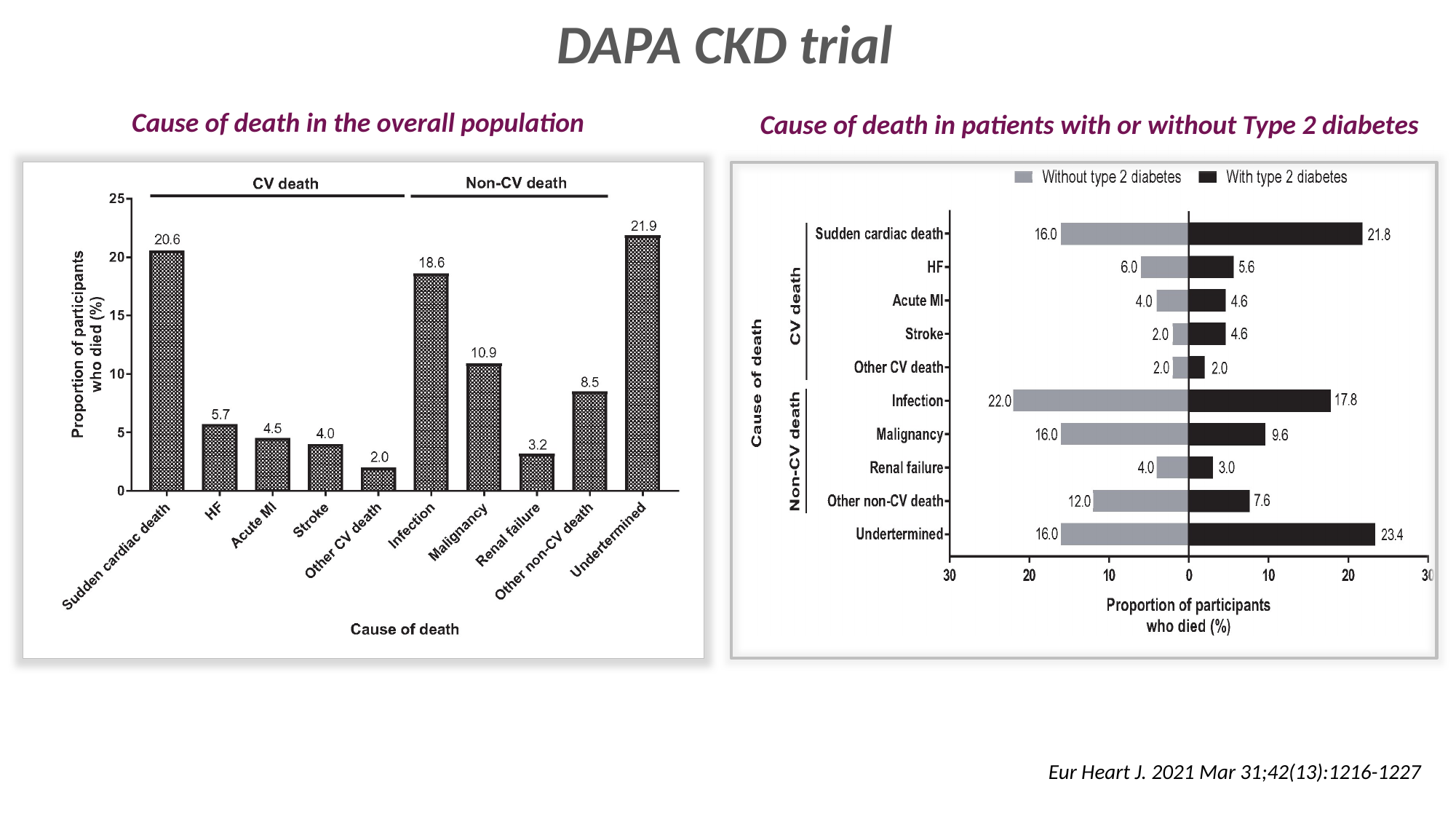
In the 'Cause of death in patients with or without Type 2 diabetes' chart, how many series does the legend list? 2 What kind of chart is the 'Cause of death in the overall population' chart? Bar chart In the 'Cause of death in the overall population' chart, which cause of death has the highest proportion? Undertermined In the 'Cause of death in patients with or without Type 2 diabetes' chart, which is larger for Malignancy: the value without type 2 diabetes or with type 2 diabetes? Without type 2 diabetes In the 'Cause of death in patients with or without Type 2 diabetes' chart, what is the value for Undertermined in patients with type 2 diabetes? 23.4 In the 'Cause of death in patients with or without Type 2 diabetes' chart, what is the value for Infection in patients without type 2 diabetes? 22.0 In the 'Cause of death in patients with or without Type 2 diabetes' chart, what is the difference between the Sudden cardiac death values with and without type 2 diabetes? 5.8 In the 'Cause of death in patients with or without Type 2 diabetes' chart, which colour represents patients with type 2 diabetes? Black In the 'Cause of death in the overall population' chart, which cause of death has the lowest proportion? Other CV death In the 'Cause of death in the overall population' chart, what is the difference between the proportions for Infection and Malignancy? 7.7 In the 'Cause of death in the overall population' chart, how many causes of death are shown on the x axis? 10 In the 'Cause of death in the overall population' chart, what is the proportion of participants who died from Sudden cardiac death? 20.6